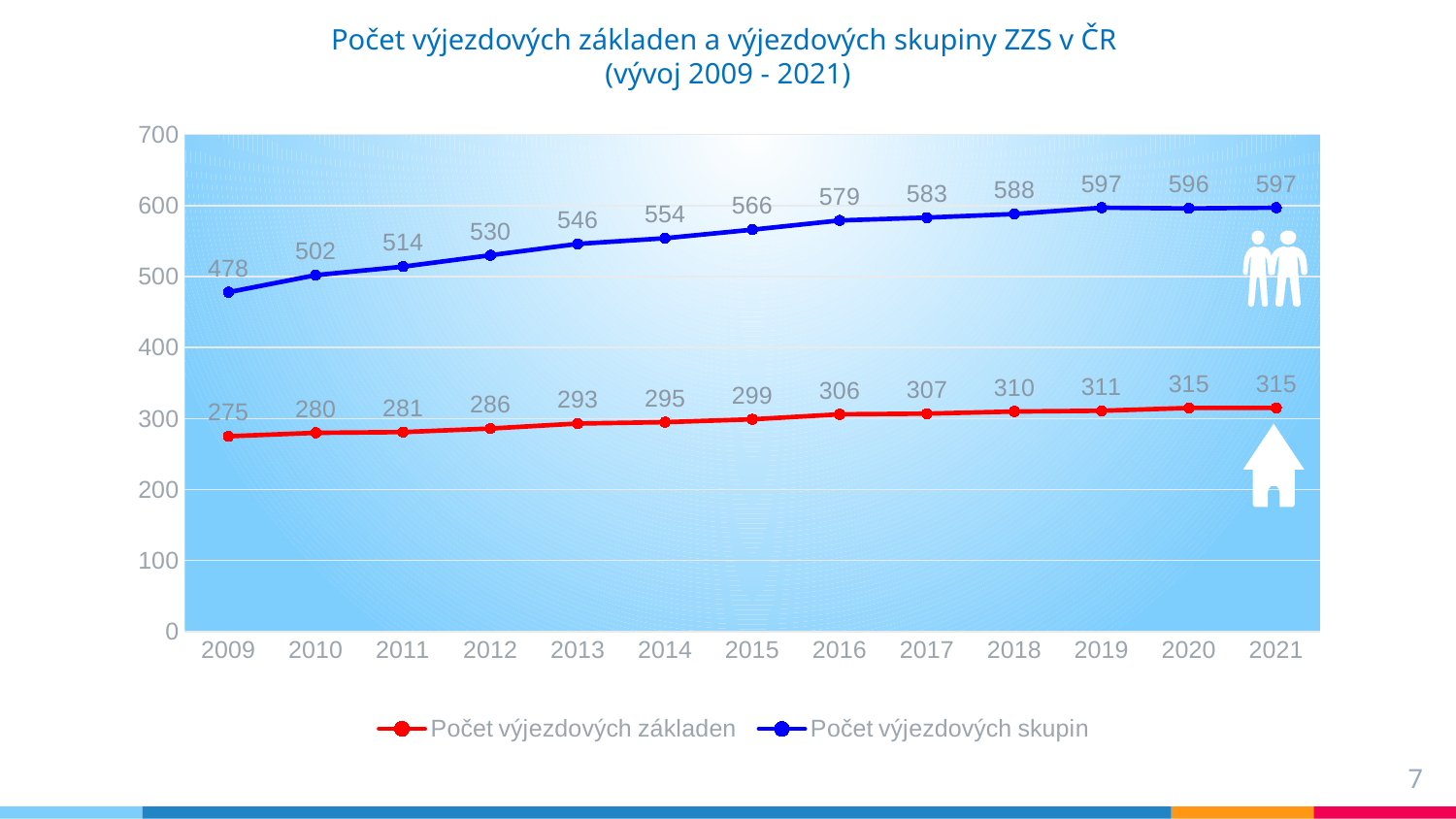
What is the value of Počet výjezdových základen in 2021? 315 In which year does Počet výjezdových skupin first reach its highest value of 597? 2019 How many years are shown on the x axis? 13 What kind of chart is shown on the slide? Line chart What is the value of Počet výjezdových skupin in 2009? 478 What is the difference between Počet výjezdových skupin and Počet výjezdových základen in 2021? 282 In which year is Počet výjezdových základen lowest? 2009 Which is larger in 2013: Počet výjezdových skupin or Počet výjezdových základen? Počet výjezdových skupin Does Počet výjezdových základen rise or fall from 2009 to 2021? Rise How many series does the legend list? 2 By how much did Počet výjezdových základen increase from 2009 to 2021? 40 What is the value of Počet výjezdových skupin in 2015? 566